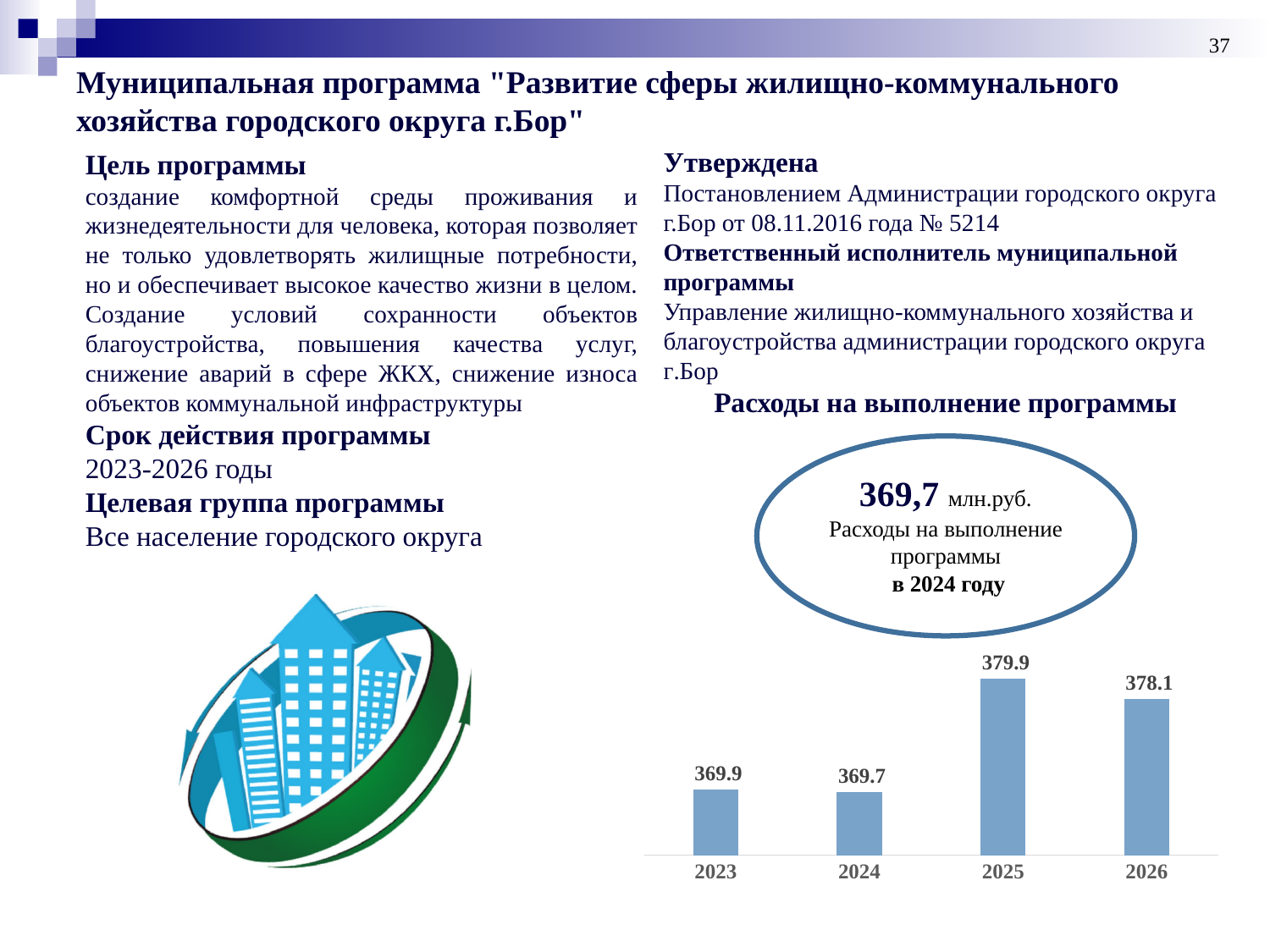
What is the value for 2023 in the chart? 369.9 What is the value for 2025 in the chart? 379.9 Which year has the lowest value in the chart? 2024 How many years are shown in the chart? 4 What is the value for 2024 in the chart? 369.7 What is the value for 2026 in the chart? 378.1 Which year has the highest value in the chart? 2025 Which is larger, the value for 2026 or the value for 2023? 2026 What is the difference between the values for 2025 and 2026? 1.8 What kind of chart is shown on the slide? bar chart What is the difference between the values for 2025 and 2024? 10.2 What is the title of the chart? Расходы на выполнение программы